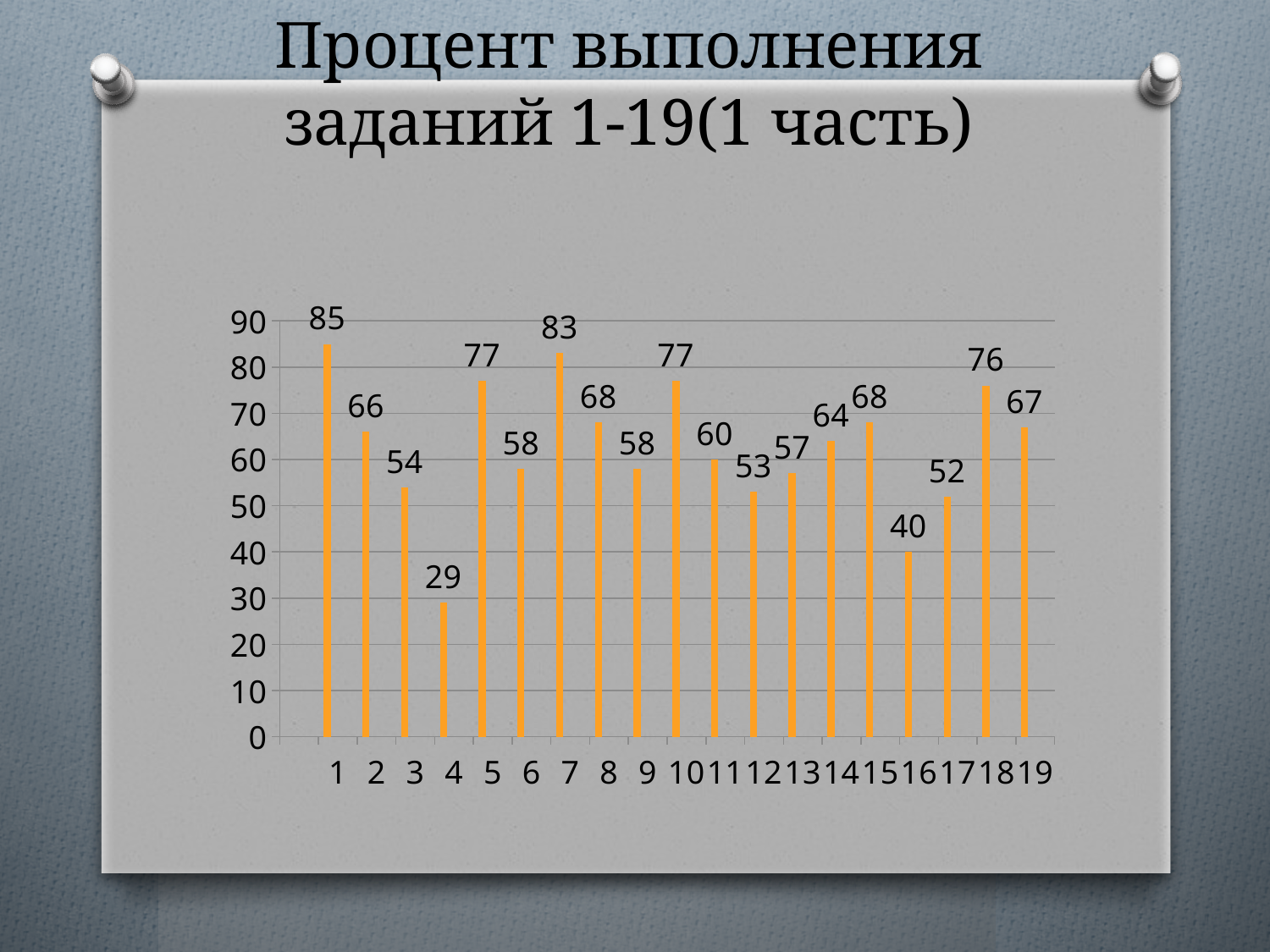
What is the value for task 1? 85 What is the difference between the values for task 7 and task 18? 7 What is the difference between the values for task 1 and task 4? 56 What is the value for task 4? 29 Which has a larger value, task 5 or task 6? task 5 Which task has the lowest value? 4 What is the value for task 19? 67 Which task has the highest value? 1 What is the title of the slide? Процент выполнения заданий 1-19(1 часть) What is the value for task 16? 40 How many tasks are shown on the x axis? 19 What kind of chart is shown on the slide? bar chart